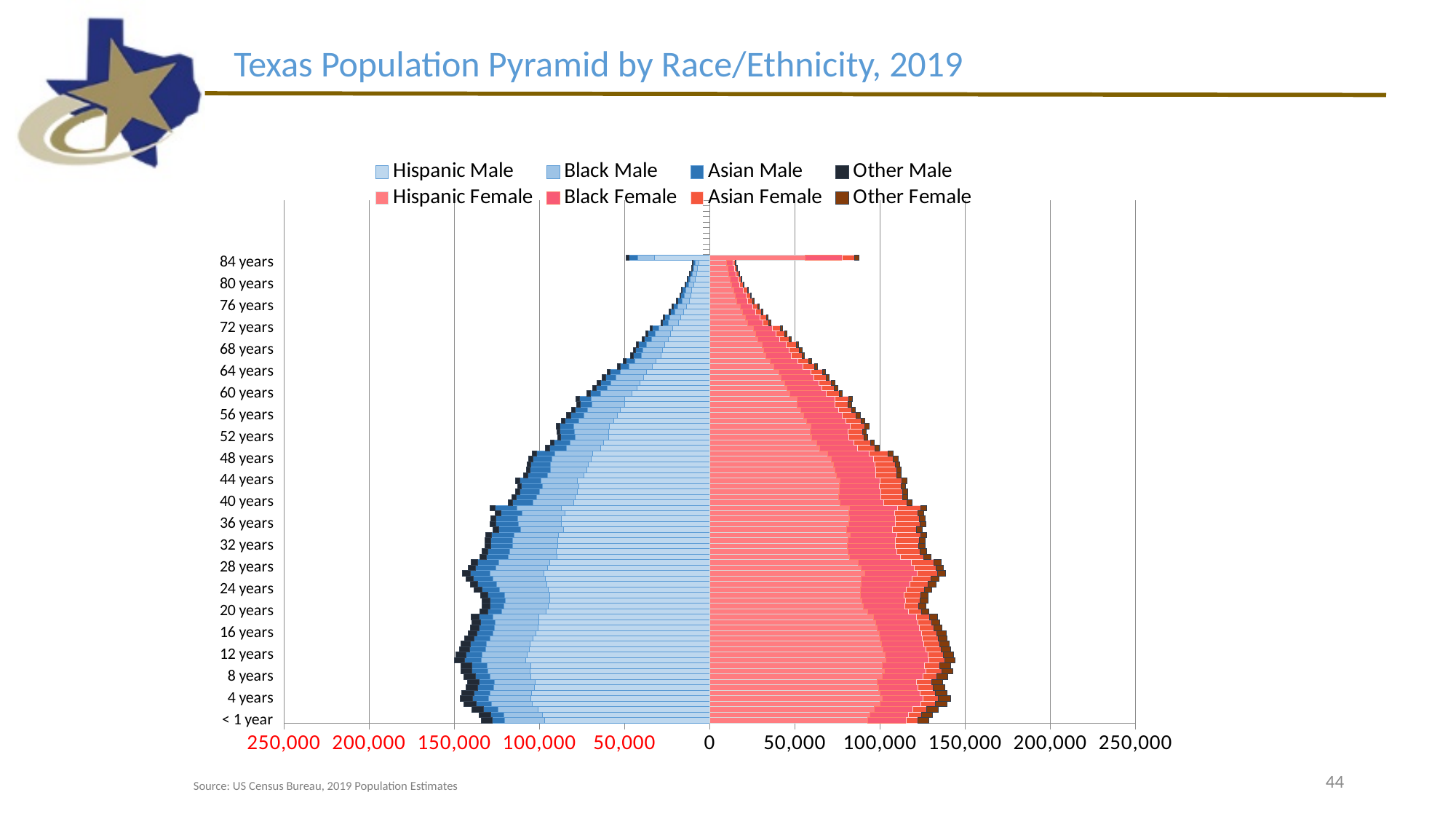
How many series does the legend list? 8 Is the total male bar for 12 years greater or less than 100,000? greater At 84 years, which is longer: the total male bar or the total female bar? Female Is the total female bar for 84 years greater or less than 100,000? less Which four series are shown on the female (right) side of the pyramid according to the legend? Hispanic Female, Black Female, Asian Female, Other Female How many age labels are shown on the vertical axis? 22 What kind of chart is shown on the slide? Bar chart (stacked population pyramid) Is the total female bar for 8 years greater or less than 200,000? less Moving from 80 years down to 20 years, do the total bars generally get longer or shorter? Longer What is the title of the chart on the slide? Texas Population Pyramid by Race/Ethnicity, 2019